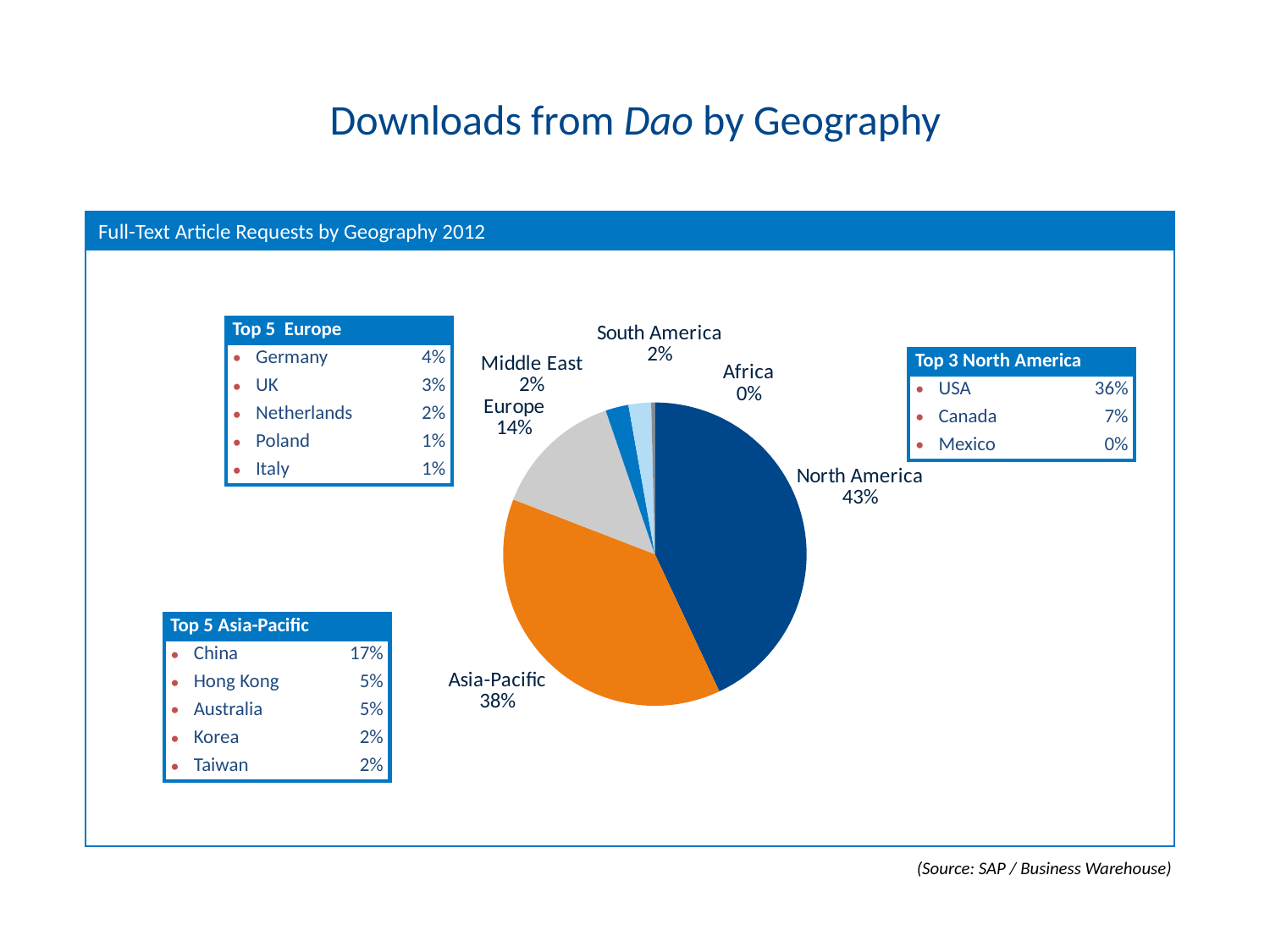
What is the difference in percentage points between North America and Asia-Pacific? 5 What is the difference in percentage points between Asia-Pacific and Europe? 24 What percentage of the pie is Asia-Pacific? 38% What percentage is shown for the Middle East slice? 2% Which region has the largest slice of the pie? North America Which region has the smallest slice of the pie? Africa What share of full-text article requests comes from North America? 43% What type of chart is shown on the slide? pie chart How many regions are shown as slices in the pie chart? 6 Which is larger, the Europe slice or the South America slice? Europe What is the title of the chart panel? Full-Text Article Requests by Geography 2012 What is the value shown for Europe in the pie chart? 14%